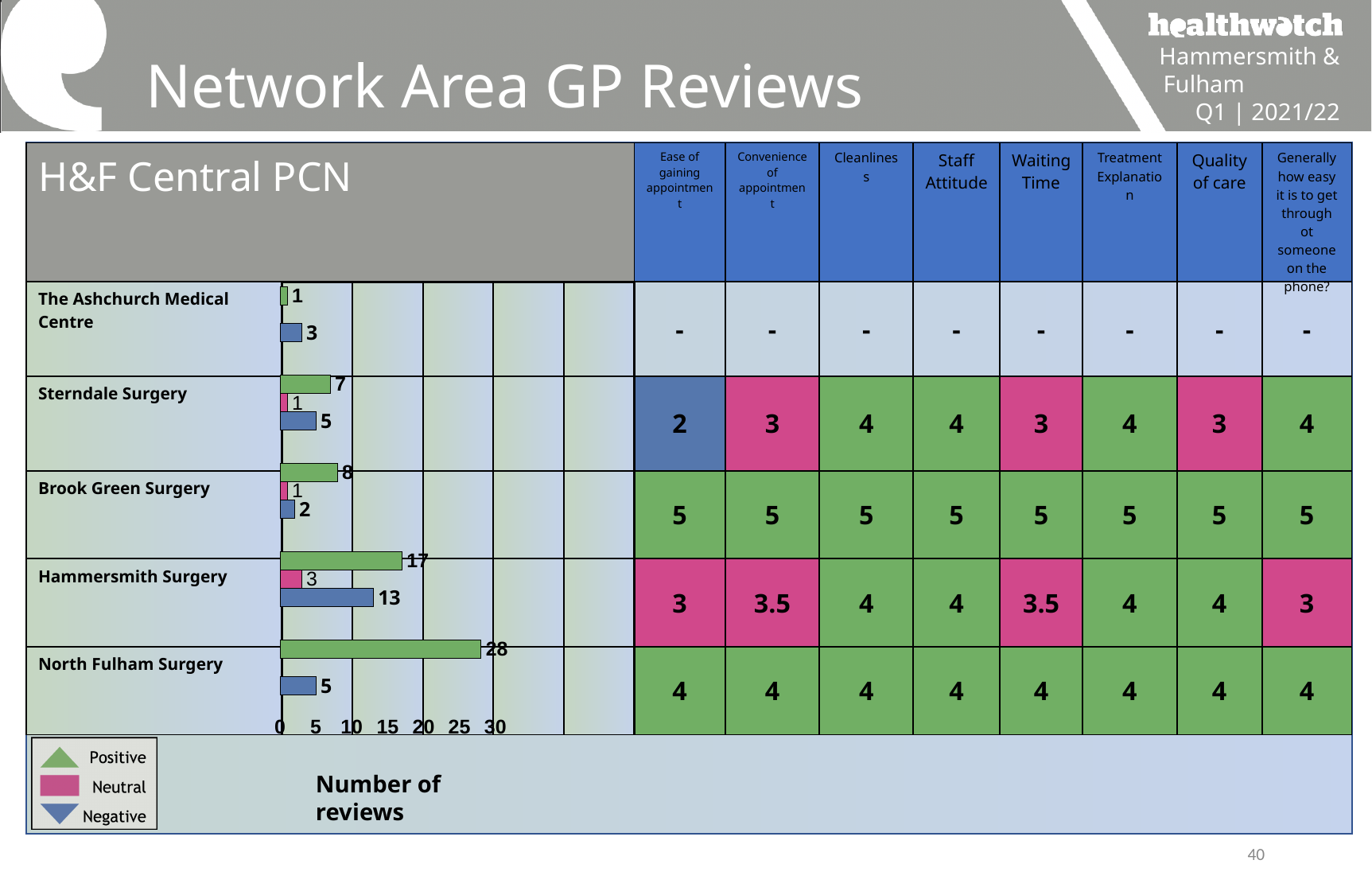
How many neutral reviews does Sterndale Surgery have in the bar chart? 1 Which is larger for Sterndale Surgery: the number of positive reviews or the number of negative reviews? Positive reviews Is the number of positive reviews for North Fulham Surgery greater or less than 25? greater How many surgeries are shown in the bar chart? 5 What colour represents Neutral reviews in the bar chart legend? Pink How many negative reviews does Hammersmith Surgery have in the bar chart? 13 Which surgery has the highest number of positive reviews in the bar chart? North Fulham Surgery How many positive reviews does North Fulham Surgery have in the bar chart? 28 What is the difference between the positive and negative review counts for Hammersmith Surgery? 4 How many series does the legend of the bar chart list? 3 Which surgery has the lowest number of positive reviews in the bar chart? The Ashchurch Medical Centre What kind of chart is used to show the number of reviews? Bar chart